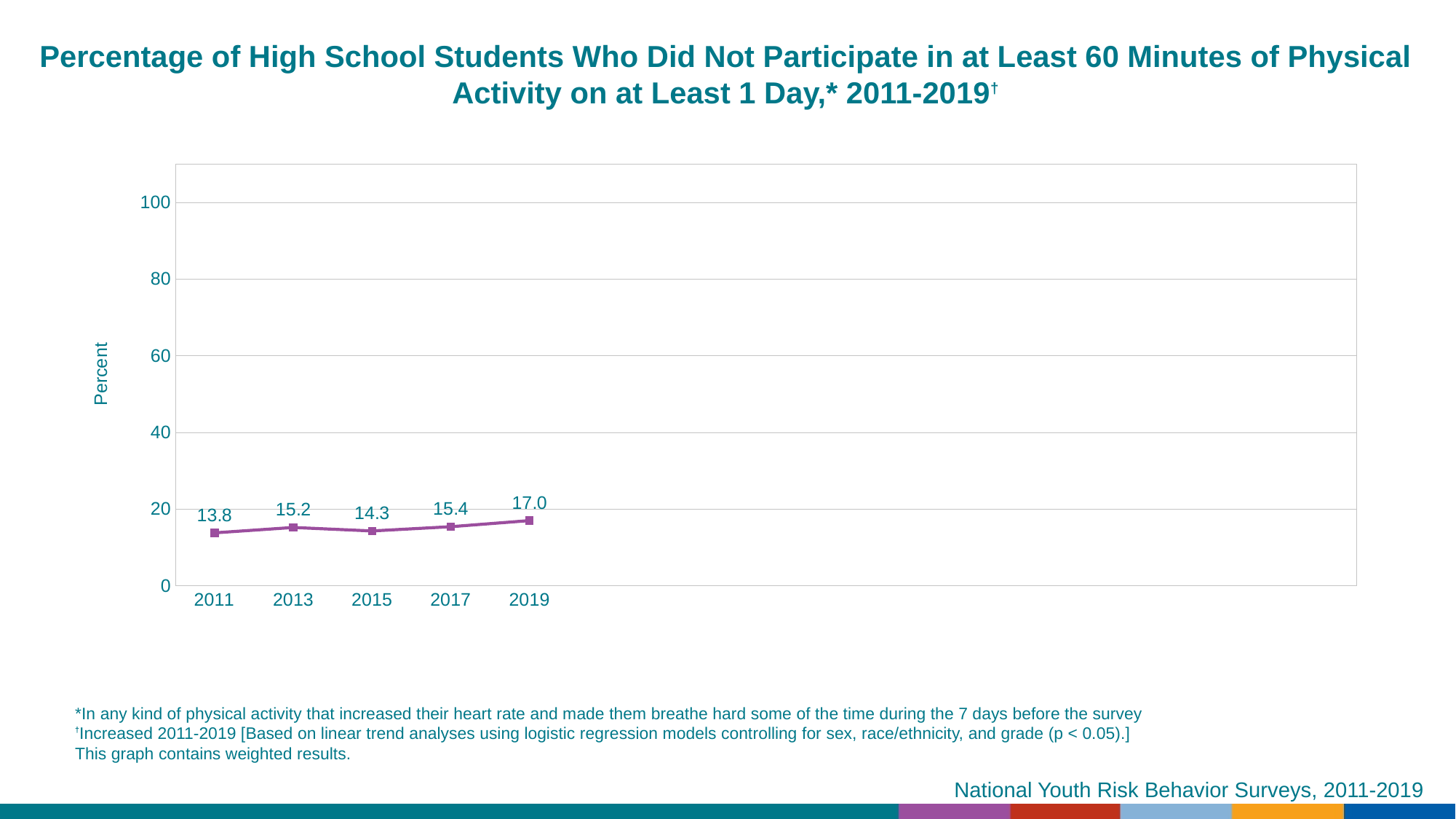
Which year has the highest value? 2019 Is the value for 2017 greater or less than 20? less What is the label on the y axis? Percent What is the difference between the values for 2019 and 2011? 3.2 What is the value for 2011? 13.8 Which year has the lowest value? 2011 What is the value for 2015? 14.3 What kind of chart is shown? line chart Do the values generally rise or fall from 2011 to 2019? rise Which is larger, the value for 2013 or the value for 2015? 2013 What is the value for 2019? 17.0 How many years are plotted on the chart? 5